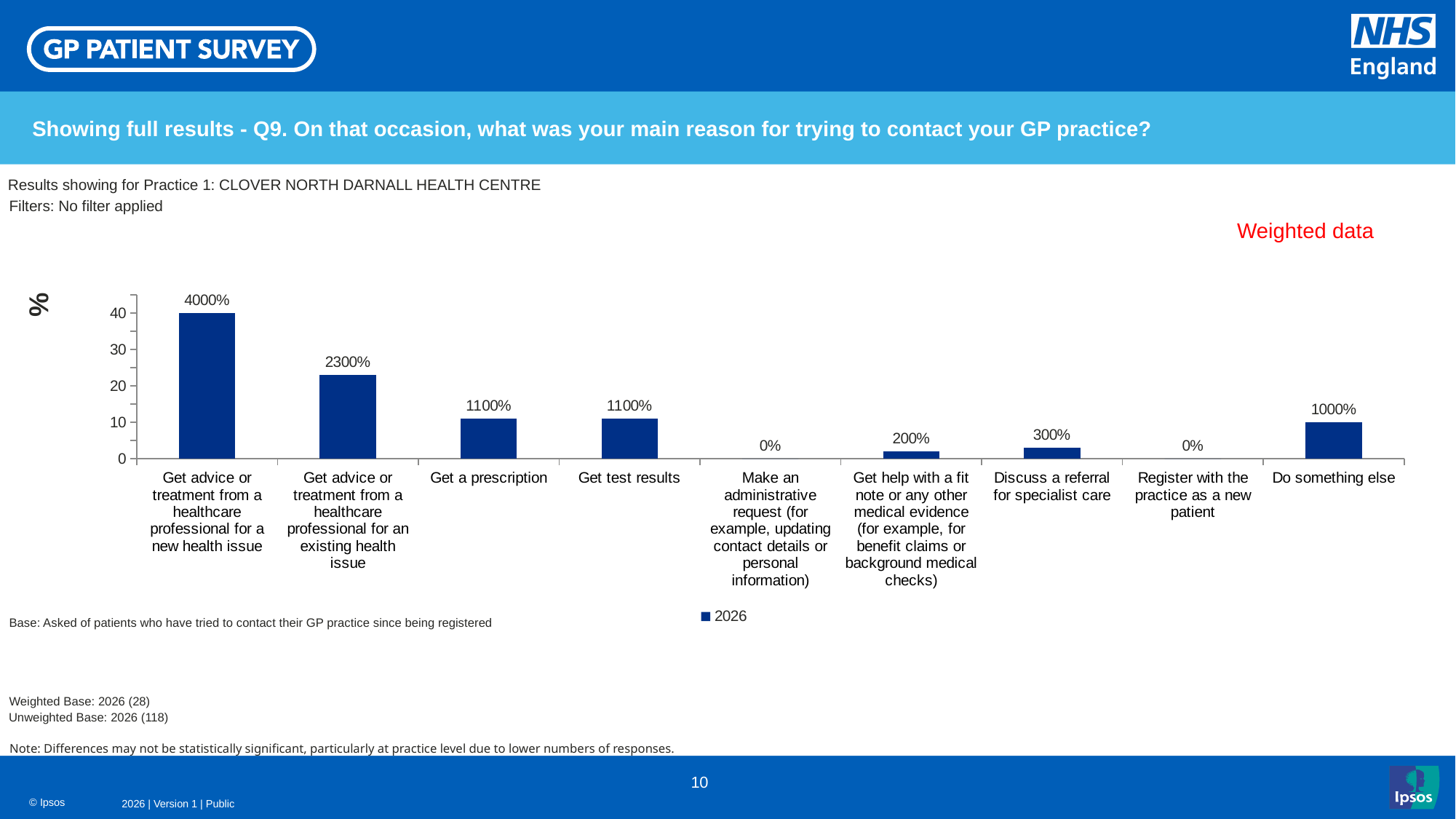
What is the data label shown for 'Discuss a referral for specialist care'? 300% What is the data label shown for 'Get a prescription'? 1100% What is the data label shown for 'Get advice or treatment from a healthcare professional for an existing health issue'? 2300% How many categories are shown on the x axis of the chart? 9 How many series does the legend list? 1 What is the data label shown for 'Get advice or treatment from a healthcare professional for a new health issue'? 4000% Which category has the highest bar in the chart? Get advice or treatment from a healthcare professional for a new health issue What is the data label shown for 'Do something else'? 1000% What is the difference between the data labels for 'Get advice or treatment from a healthcare professional for a new health issue' and 'Get advice or treatment from a healthcare professional for an existing health issue'? 1700% Which is larger: the value for 'Discuss a referral for specialist care' or the value for 'Get help with a fit note or any other medical evidence'? Discuss a referral for specialist care What kind of chart is shown on the slide? Bar chart How many categories show a data label of 0%? 2